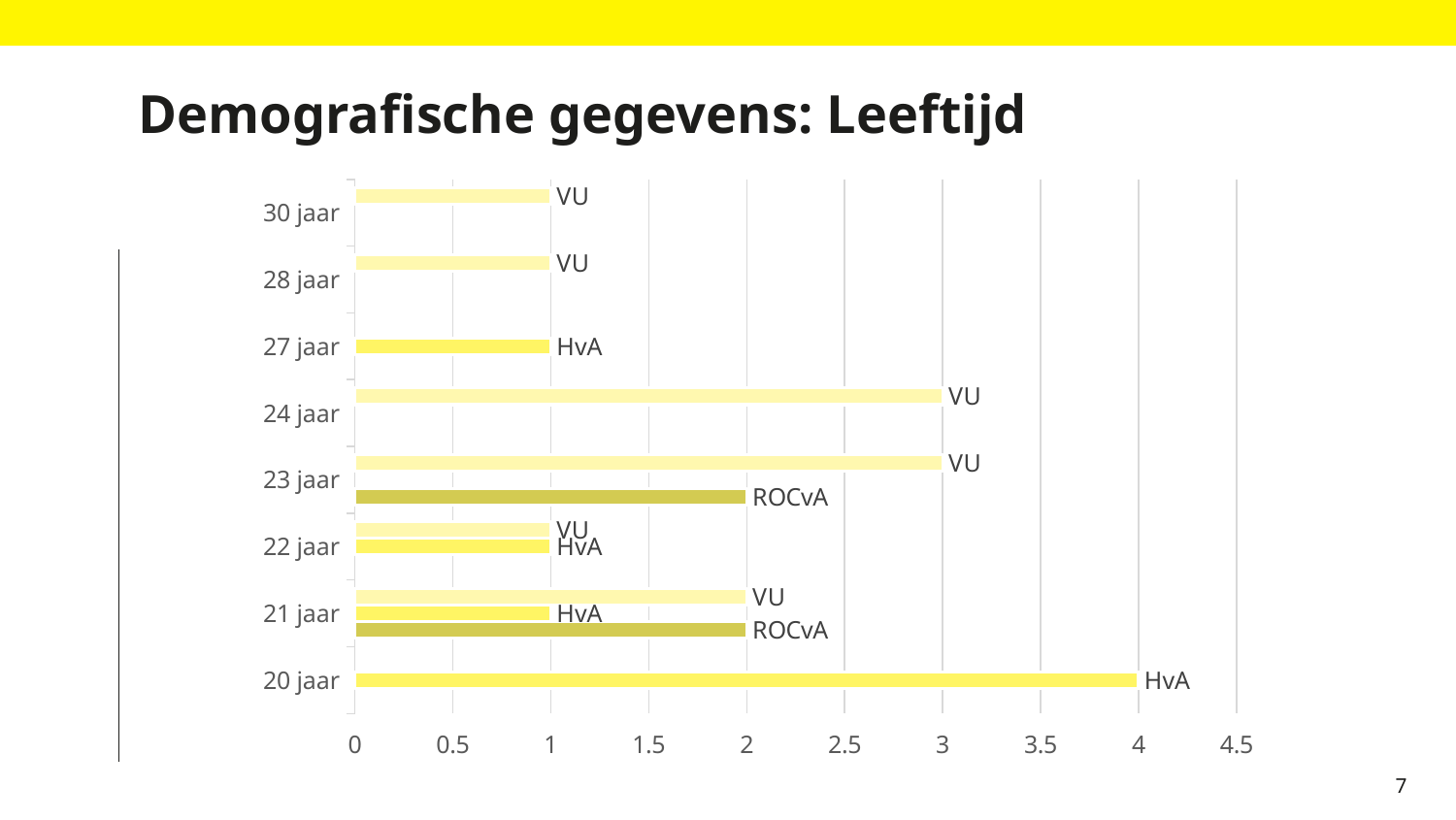
Which institution is labelled on the bar for 27 jaar? HvA Which is larger: the VU bar for 23 jaar or the ROCvA bar for 23 jaar? VU Is the value of the HvA bar for 20 jaar greater or less than 3? greater How many age categories are shown on the vertical axis? 8 What is the title of the slide? Demografische gegevens: Leeftijd What is the difference between the HvA bar for 20 jaar and the VU bar for 24 jaar? 1 What is the value of the VU bar for 21 jaar? 2 What is the value of the ROCvA bar for 23 jaar? 2 What is the value of the VU bar for 24 jaar? 3 Which age category has the longest bar? 20 jaar What is the value of the HvA bar for 20 jaar? 4 What kind of chart is shown on the slide? bar chart